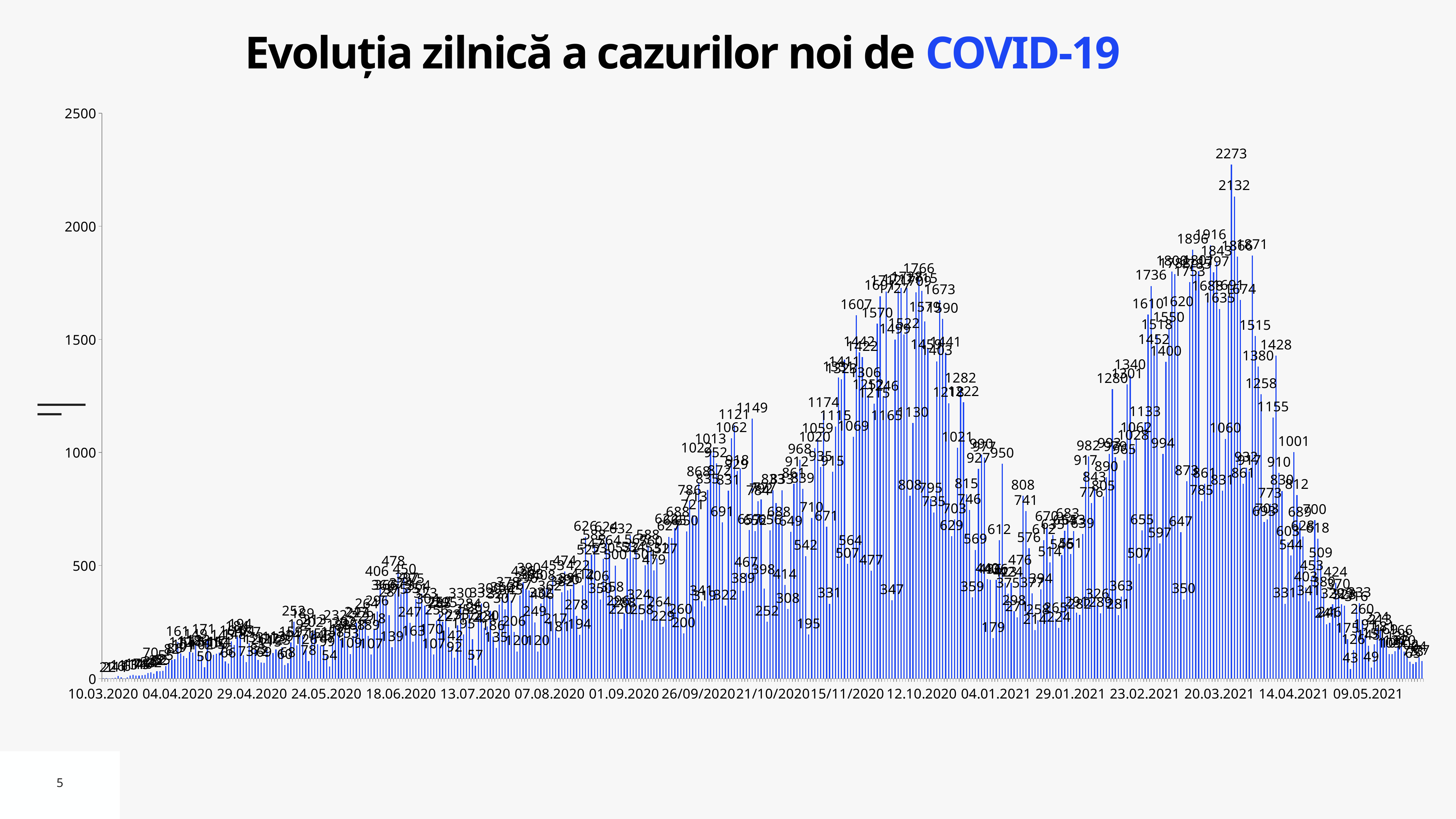
Which is larger: the peak of daily cases in late 2020 (around 12.10.2020) or the peak in 2021 (around 20.03.2021)? the 2021 peak (around 20.03.2021) What is the highest daily value labeled on the chart? 2273 What is the difference between the two highest labeled values, 2273 and 2132? 141 Do the daily values rise or fall between 14.04.2021 and 09.05.2021? fall Do the daily values rise or fall between 10.03.2020 and 04.04.2020? rise What is the title of the chart? Evoluția zilnică a cazurilor noi de COVID-19 Is the highest bar on the chart greater or less than 2000? greater Is the value for the first date, 10.03.2020, greater or less than 500? less What kind of chart is shown on the slide? bar chart What is the first date label shown on the x axis? 10.03.2020 What is the second highest daily value labeled on the chart? 2132